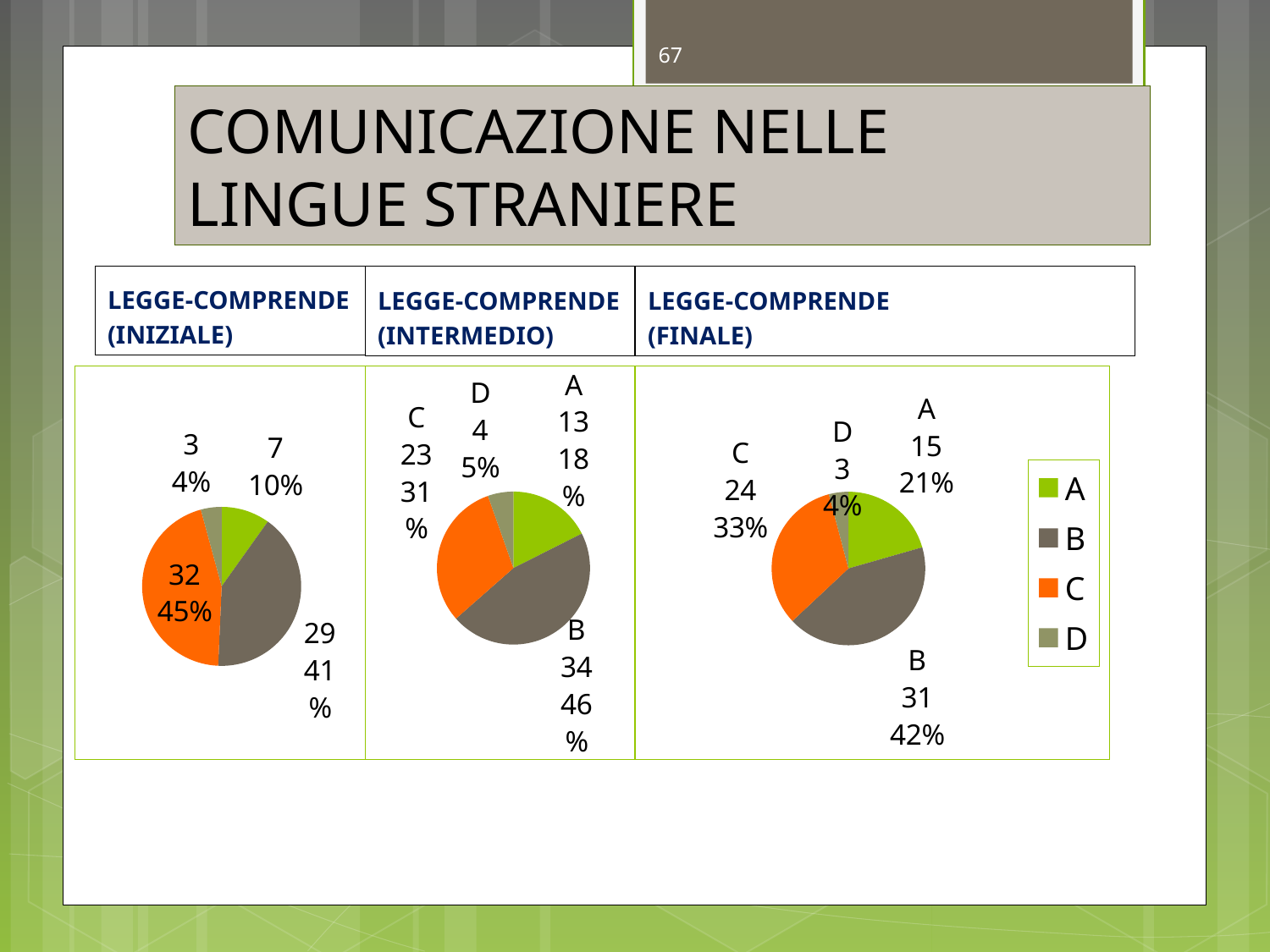
In the LEGGE-COMPRENDE (INTERMEDIO) chart, what is the percentage share of category D? 5% In the LEGGE-COMPRENDE (INTERMEDIO) chart, which category has the largest share? B In the LEGGE-COMPRENDE (FINALE) chart, what is the count shown for category C? 24 How many pie charts are shown on the slide? 3 In the LEGGE-COMPRENDE (INTERMEDIO) chart, what is the count shown for category B? 34 How many categories does the legend list? 4 In the LEGGE-COMPRENDE (INTERMEDIO) chart, which is larger, the share of A or the share of C? C What type of chart is used for LEGGE-COMPRENDE (FINALE)? Pie chart In the LEGGE-COMPRENDE (FINALE) chart, what percentage share does category A have? 21% In the LEGGE-COMPRENDE (FINALE) chart, which category has the smallest share? D In the LEGGE-COMPRENDE (FINALE) chart, what is the difference between the counts for B and C? 7 In the LEGGE-COMPRENDE (INIZIALE) chart, what is the largest percentage shown? 45%